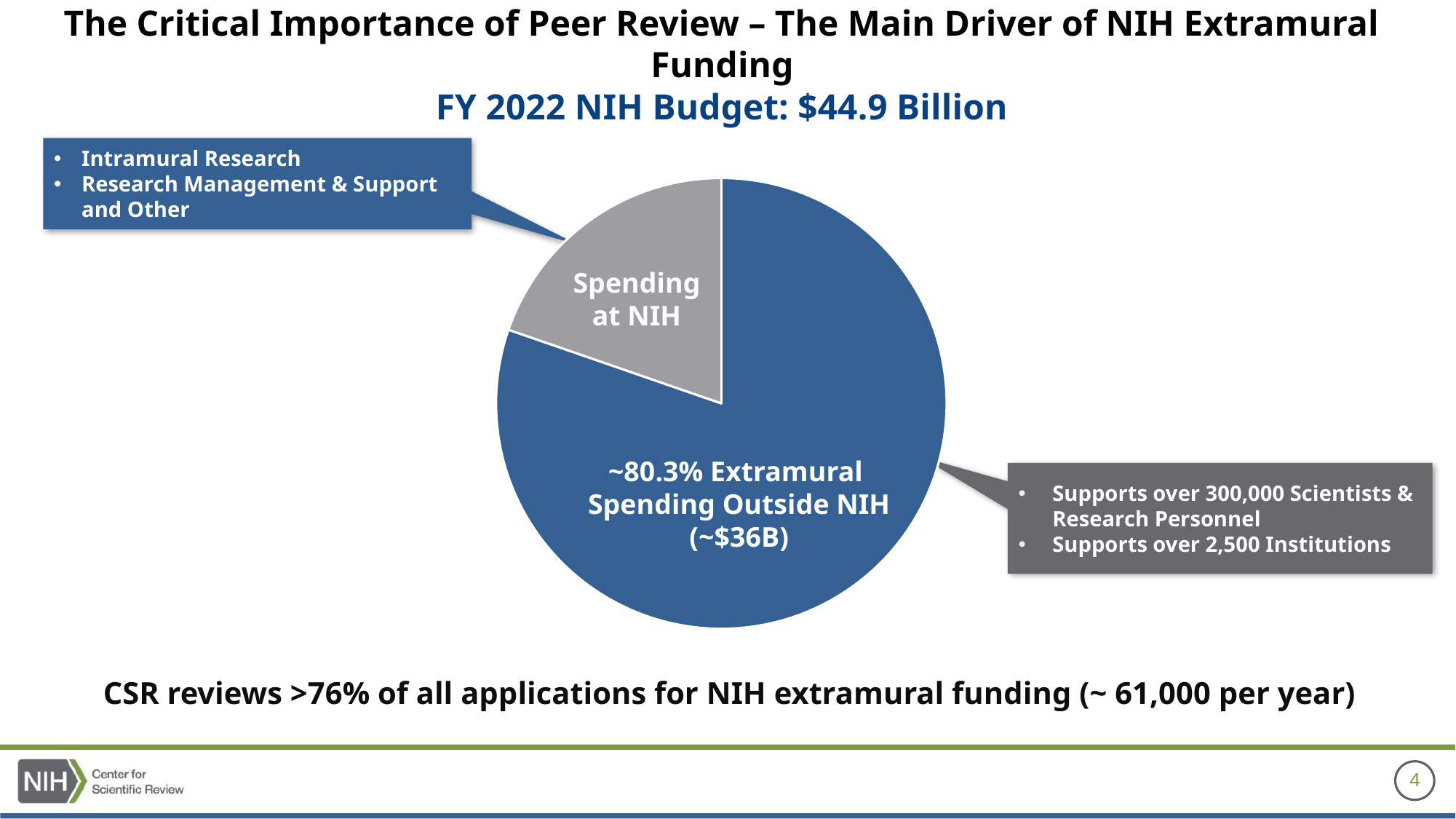
Is the share of the pie for Spending at NIH greater or less than 50%? less How many slices does the pie chart have? 2 What dollar amount is printed on the Extramural Spending Outside NIH slice? ~$36B Which slice of the pie chart is the largest? Extramural Spending Outside NIH What colour is the Spending at NIH slice? grey What percentage label is printed on the Extramural Spending Outside NIH slice? ~80.3% What total budget is stated in the heading above the pie chart? FY 2022 NIH Budget: $44.9 Billion Which slice of the pie chart is the smallest? Spending at NIH Which is larger in the pie chart: Spending at NIH or Extramural Spending Outside NIH? Extramural Spending Outside NIH What kind of chart is shown on the slide? pie chart